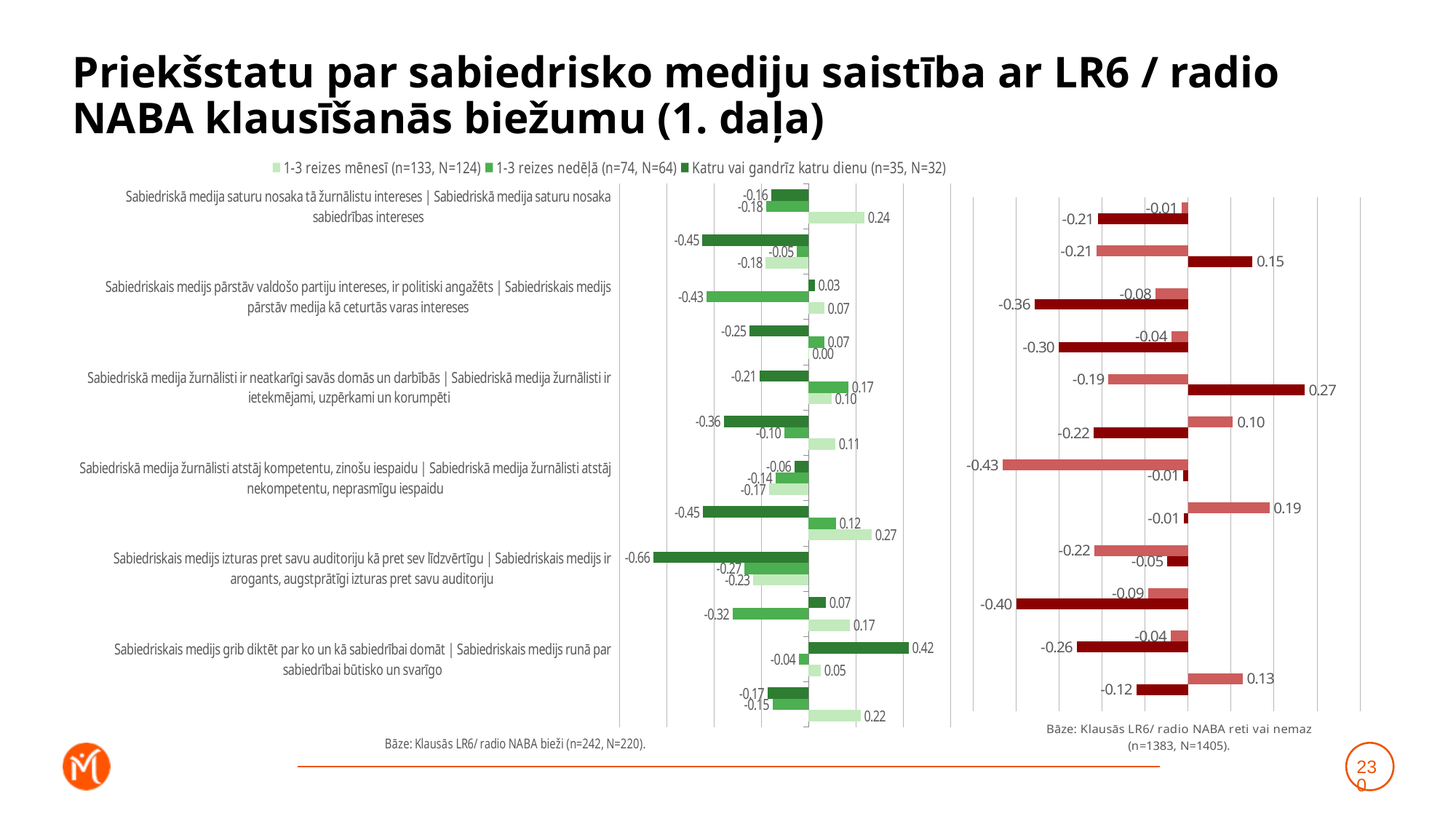
In the green chart, for the first category, which is larger: the '1-3 reizes mēnesī' value or the '1-3 reizes nedēļā' value? 1-3 reizes mēnesī In the green chart, what is the value of the 'Katru vai gandrīz katru dienu' series for the first category, 'Sabiedriskā medija saturu nosaka tā žurnālistu intereses | Sabiedriskā medija saturu nosaka sabiedrības intereses'? -0.16 In the green chart, what is the highest value shown by a data label? 0.42 What kind of chart is the green chart on the left of the slide? bar chart In the green chart, what is the difference between the '1-3 reizes mēnesī' value (0.24) and the 'Katru vai gandrīz katru dienu' value (-0.16) for the first category? 0.40 In the red chart on the right, what is the lowest value shown by a data label? -0.43 How many series does the legend above the green chart list? 3 What base (Bāze) is stated below the green chart? Klausās LR6/ radio NABA bieži (n=242, N=220). In the green chart, what is the value of the 'Katru vai gandrīz katru dienu' series for the category 'Sabiedriskais medijs grib diktēt par ko un kā sabiedrībai domāt | Sabiedriskais medijs runā par sabiedrībai būtisko un svarīgo'? 0.42 In the red chart on the right, what is the highest value shown by a data label? 0.27 In the green chart, what is the value of the '1-3 reizes mēnesī' series for the first category, 'Sabiedriskā medija saturu nosaka tā žurnālistu intereses | Sabiedriskā medija saturu nosaka sabiedrības intereses'? 0.24 In the green chart, what is the lowest value shown by a data label? -0.66